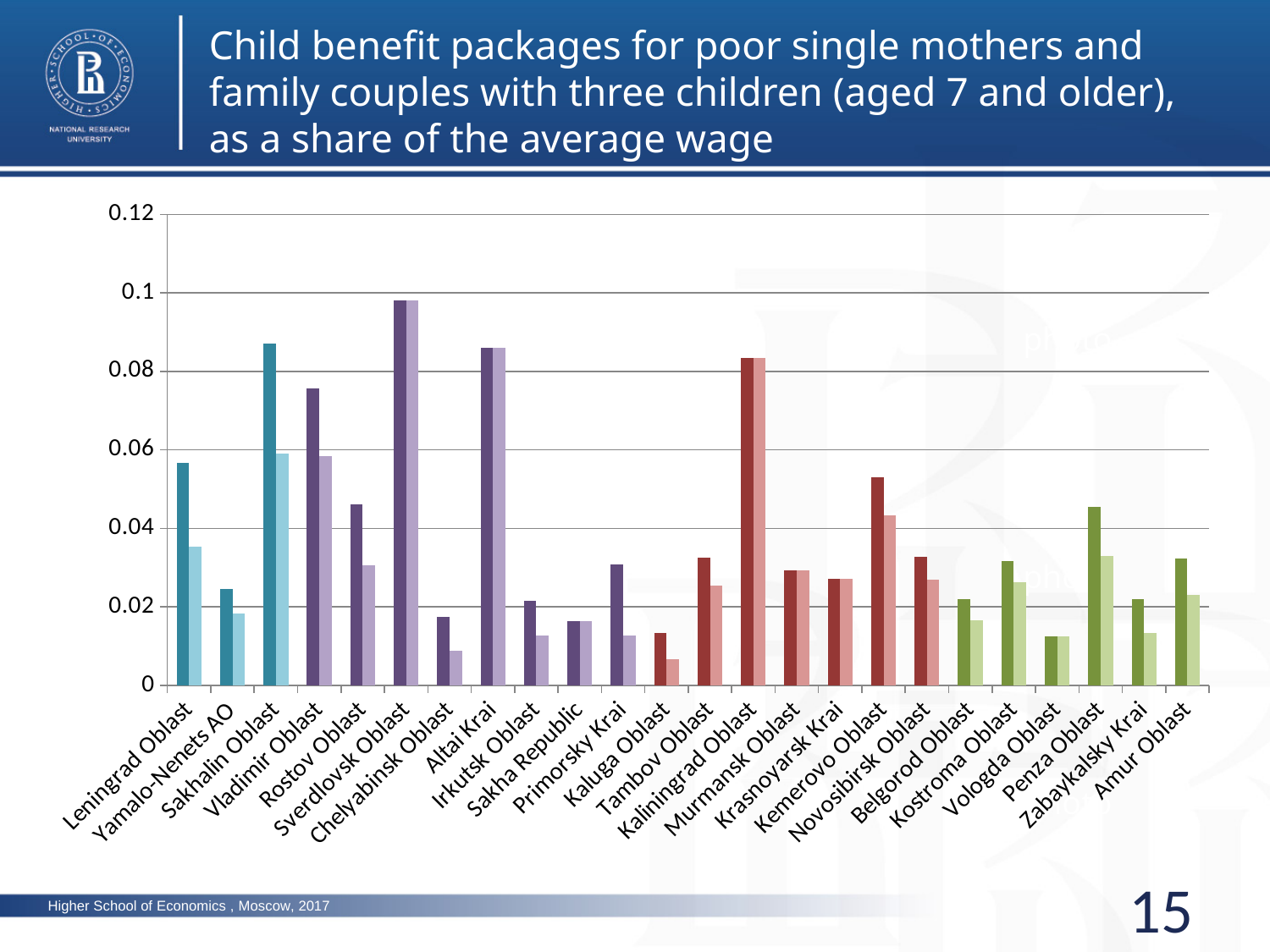
Is the value of the darker bar for Sakhalin Oblast greater or less than 0.08? greater Is the value of the darker bar for Kemerovo Oblast greater or less than 0.04? greater What kind of chart is shown on the slide? bar chart How many bars are plotted for each region in the chart? 2 Which has the larger darker bar, Kemerovo Oblast or Novosibirsk Oblast? Kemerovo Oblast Which has the larger darker bar, Leningrad Oblast or Yamalo-Nenets AO? Leningrad Oblast Is the value of the darker bar for Altai Krai greater or less than 0.08? greater What is the highest value shown on the y axis of the chart? 0.12 How many regions are listed along the x axis of the chart? 24 Which region has the tallest bars in the chart? Sverdlovsk Oblast